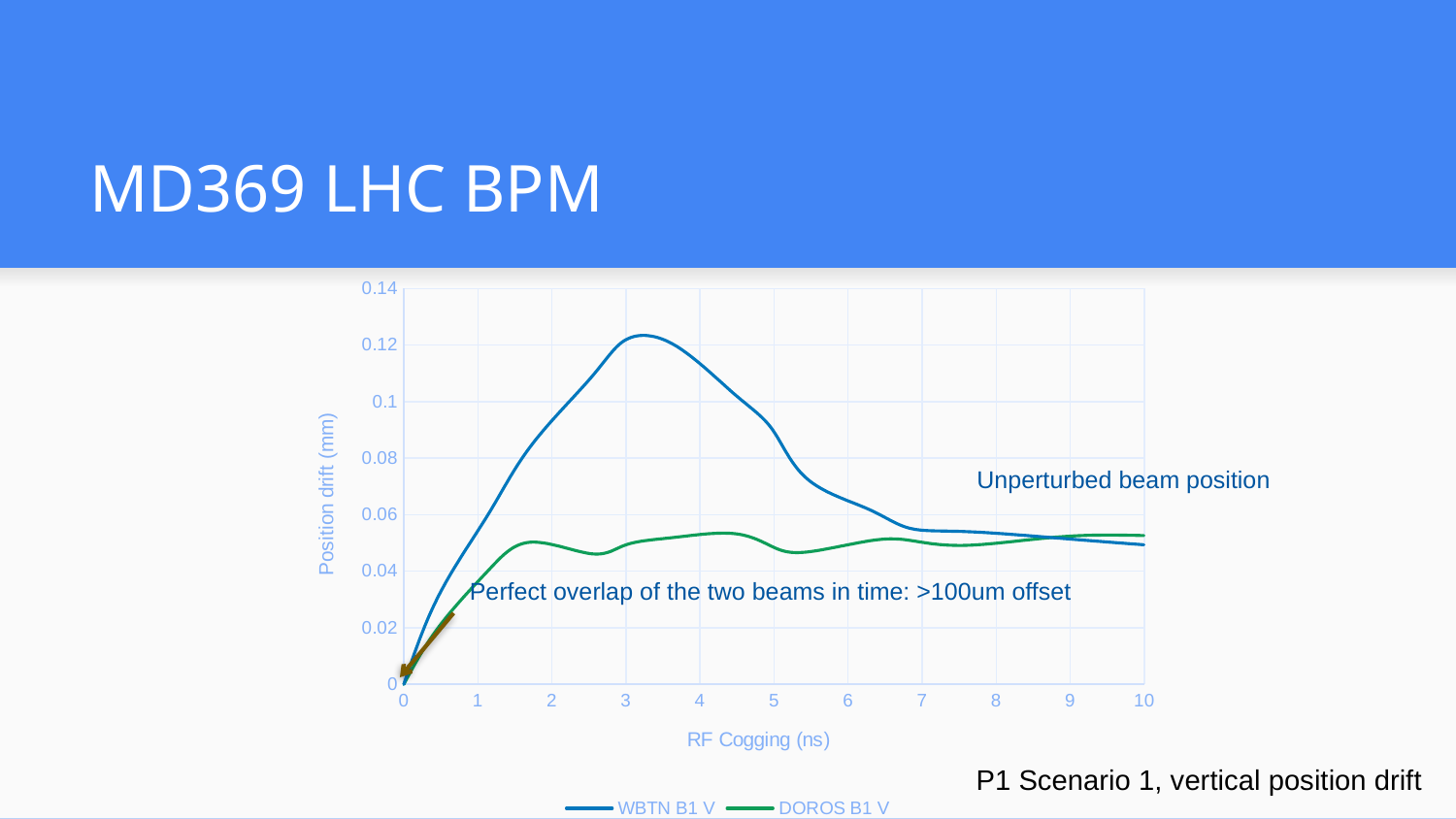
Is the value of the WBTN B1 V series at RF Cogging 2 ns greater or less than 0.08? greater Is the peak value of the WBTN B1 V series greater or less than 0.12? greater Is the value of the DOROS B1 V series at RF Cogging 4 ns greater or less than 0.06? less Does the WBTN B1 V series rise or fall between RF Cogging 0 ns and 3 ns? rise How many series does the legend list? 2 What is the position drift of both series at RF Cogging 0 ns? 0 What is the label of the x axis? RF Cogging (ns) At RF Cogging 10 ns, which series has the higher position drift, WBTN B1 V or DOROS B1 V? DOROS B1 V At RF Cogging 3 ns, which series has the higher position drift, WBTN B1 V or DOROS B1 V? WBTN B1 V What are the two series named in the legend? WBTN B1 V and DOROS B1 V Does the WBTN B1 V series rise or fall between RF Cogging 3 ns and 7 ns? fall What kind of chart is shown on the slide? line chart